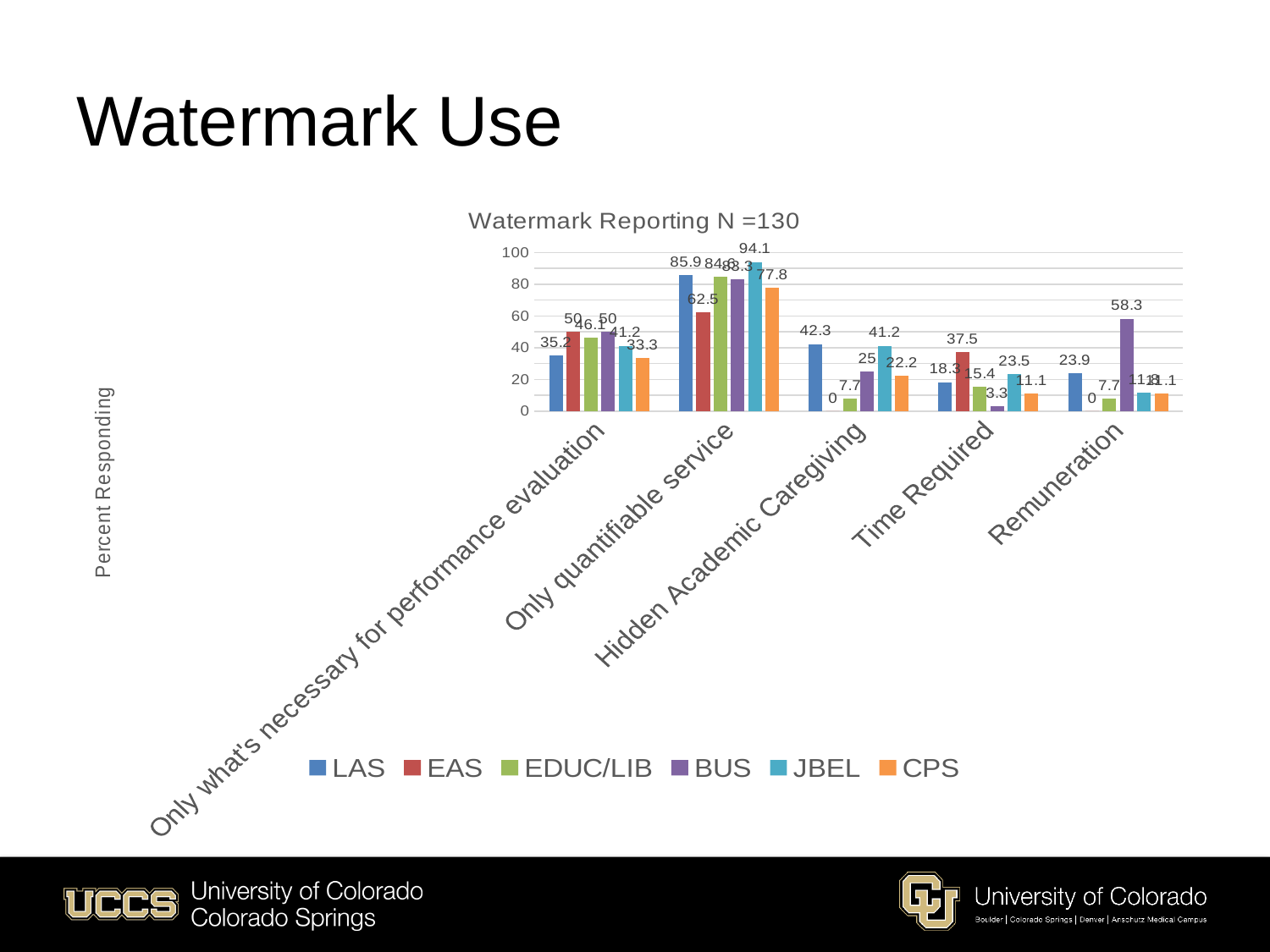
Which series has the highest value in the Only quantifiable service category? JBEL How many series does the legend list? 6 What is the title of the chart? Watermark Reporting N =130 What is the value for JBEL in the Only quantifiable service category? 94.1 What is the difference between the JBEL and CPS values in the Only quantifiable service category? 16.3 What is the value for EAS in the Time Required category? 37.5 Which is larger in the Hidden Academic Caregiving category, the value for BUS or the value for CPS? BUS What is the value for LAS in the Hidden Academic Caregiving category? 42.3 Which series has the lowest value in the Time Required category? BUS What is the value for LAS in the Only quantifiable service category? 85.9 How many categories are shown on the x axis? 5 What is the value for BUS in the Remuneration category? 58.3